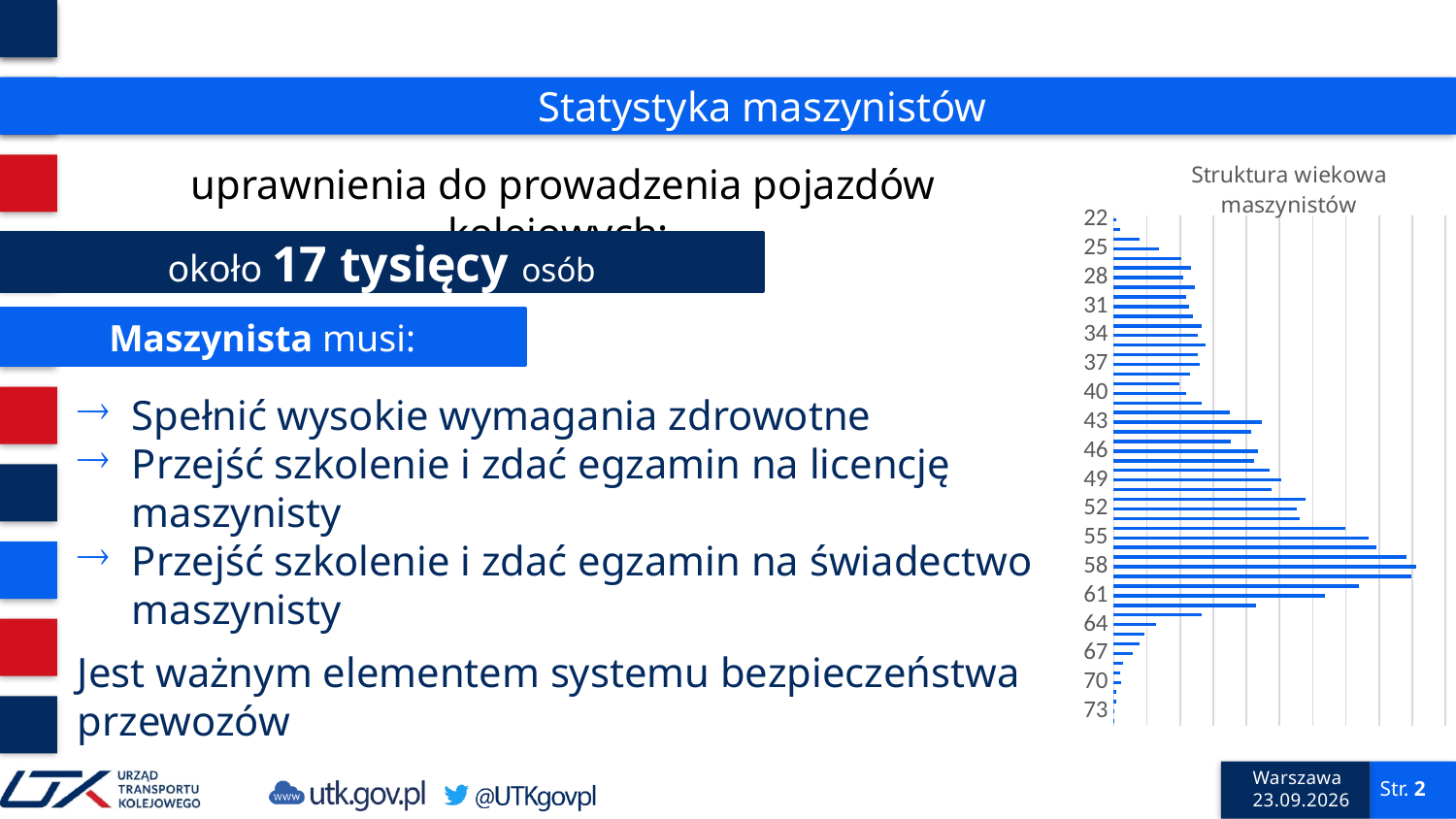
Do the bar lengths generally rise or fall as age increases from 22 to 58? rise Which age has the longer bar, 64 or 52? 52 What kind of chart is shown on the slide? bar chart Do the bar lengths generally rise or fall as age increases from 58 to 73? fall Are the bars in the chart oriented horizontally or vertically? horizontally Which age has the longer bar, 40 or 55? 55 What is the highest age label shown on the chart's vertical axis? 73 What is the title of the chart on the right of the slide? Struktura wiekowa maszynistów Which age has the longer bar, 22 or 49? 49 What is the lowest age label shown on the chart's vertical axis? 22